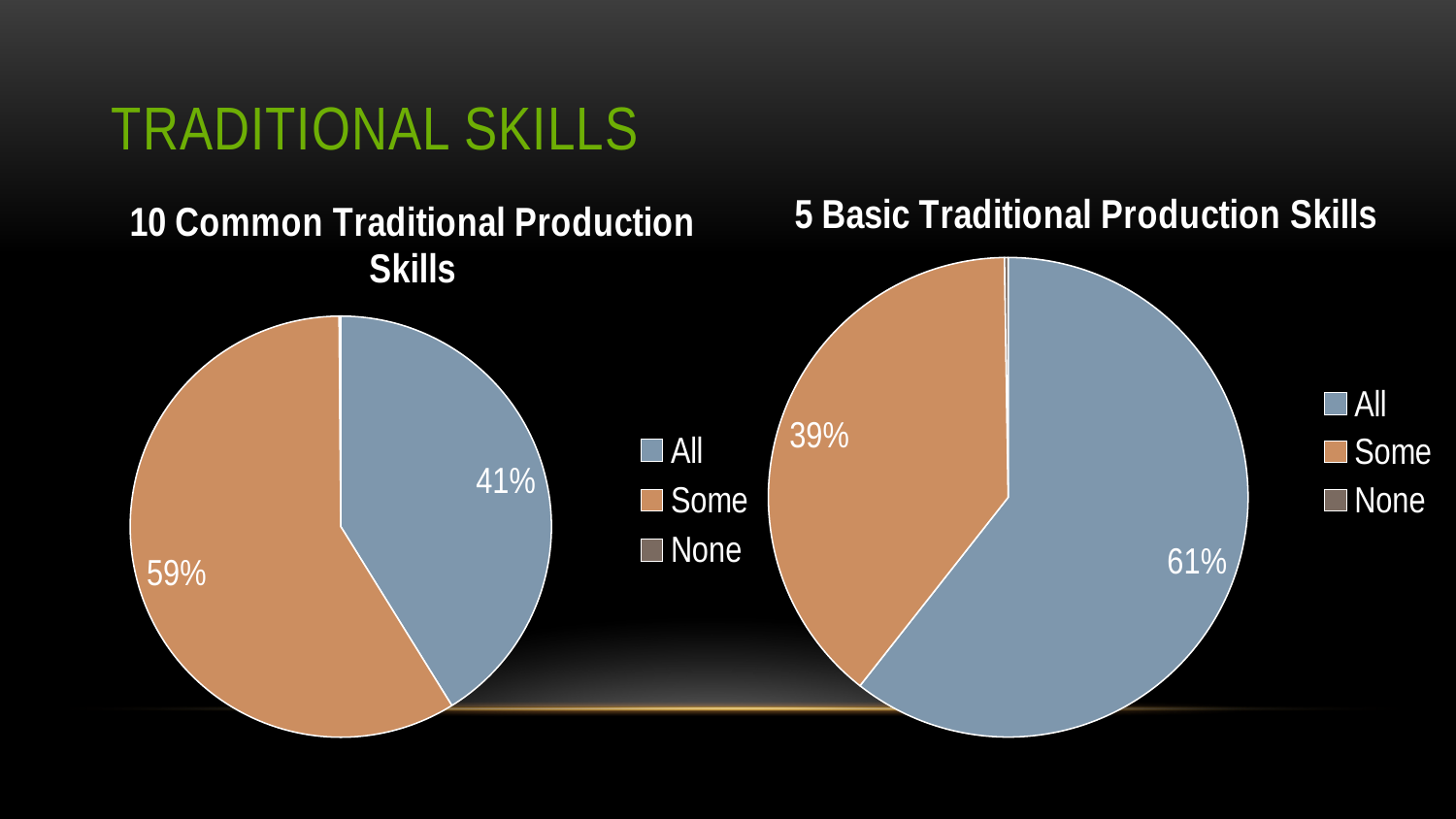
In the '5 Basic Traditional Production Skills' chart, which category has the largest slice? All In the '5 Basic Traditional Production Skills' chart, what share is labelled for 'All'? 61% In the '10 Common Traditional Production Skills' chart, what share is labelled for 'All'? 41% In the '10 Common Traditional Production Skills' chart, what is the difference between the 'Some' and 'All' shares? 18% Which is larger: the 'All' share in the '10 Common Traditional Production Skills' chart or the 'All' share in the '5 Basic Traditional Production Skills' chart? 5 Basic Traditional Production Skills In the '5 Basic Traditional Production Skills' chart, what is the difference between the 'All' and 'Some' shares? 22% In the '5 Basic Traditional Production Skills' chart, what share is labelled for 'Some'? 39% In the '5 Basic Traditional Production Skills' chart, what colour is the 'Some' slice? Orange How many entries does the legend of the '10 Common Traditional Production Skills' chart list? 3 In the '10 Common Traditional Production Skills' chart, which category has the largest slice? Some What kind of chart is the '5 Basic Traditional Production Skills' chart? Pie chart In the '10 Common Traditional Production Skills' chart, what share is labelled for 'Some'? 59%